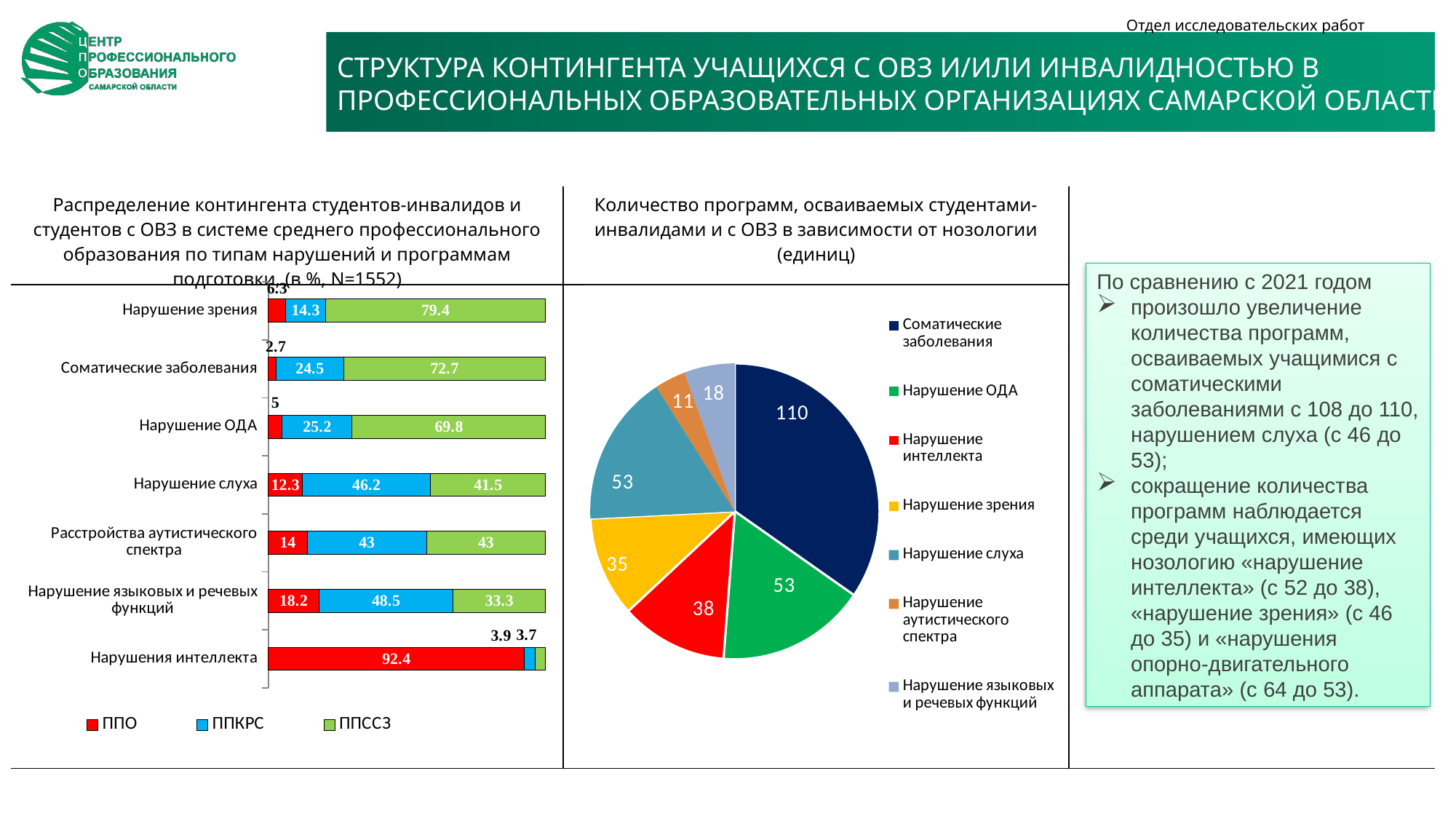
In the pie chart, which category has the smallest value? Нарушение аутистического спектра In the pie chart, what is the difference between Соматические заболевания and Нарушение ОДА? 57 In the pie chart, which is larger: Нарушение интеллекта or Нарушение зрения? Нарушение интеллекта In the left chart, what is the ППО value for Нарушения интеллекта? 92.4 What kind of chart is the left chart? Bar chart In the left chart, what is the ППКРС value for Нарушение слуха? 46.2 In the left chart, what is the difference between the ППКРС and ППО values for Нарушение языковых и речевых функций? 30.3 In the left chart, which category has the highest ППО value? Нарушения интеллекта In the pie chart (Количество программ...), what is the value for Соматические заболевания? 110 In the left chart (Распределение контингента студентов-инвалидов...), what is the ППССЗ value for Нарушение зрения? 79.4 In the left chart, how many series does the legend list? 3 In the pie chart, how many categories are shown? 7